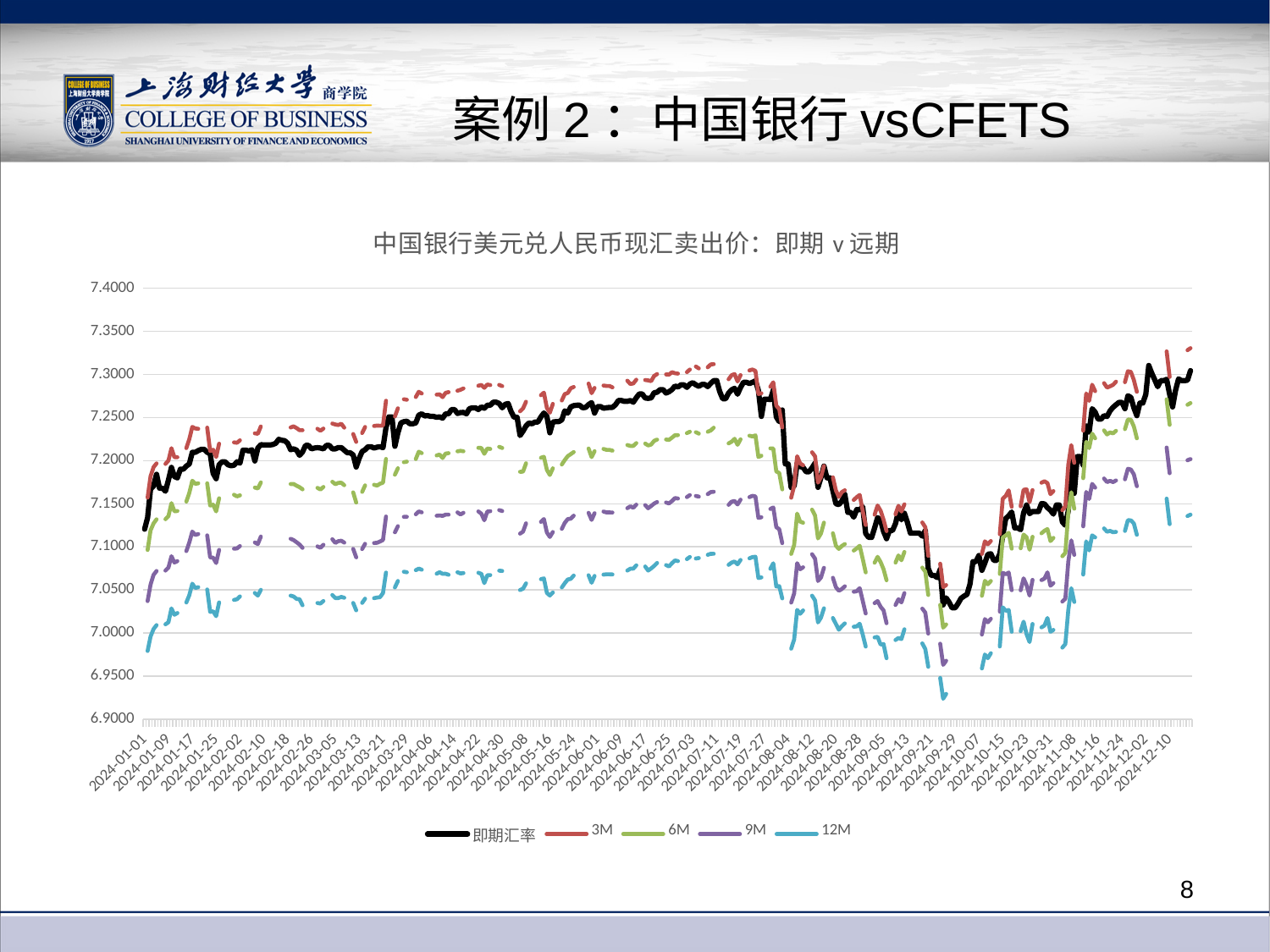
Is the value of the 12M series at 2024-01-01 greater or less than 7.0000? less Which series lies lowest on the chart across the whole period? 12M Is the value of the 即期汇率 series at 2024-07-11 greater or less than 7.2500? greater Is the value of the 即期汇率 series at 2024-09-29 greater or less than 7.1000? less What is the title of the chart? 中国银行美元兑人民币现汇卖出价：即期 v 远期 Which series lies highest on the chart across the whole period? 3M How many series does the legend list? 5 At 2024-06-01, which is larger, the 3M series or the 12M series? 3M Which colour is used for the 即期汇率 series? black Does the 即期汇率 series rise or fall between 2024-07-27 and 2024-09-29? fall What kind of chart is shown on the slide? line chart